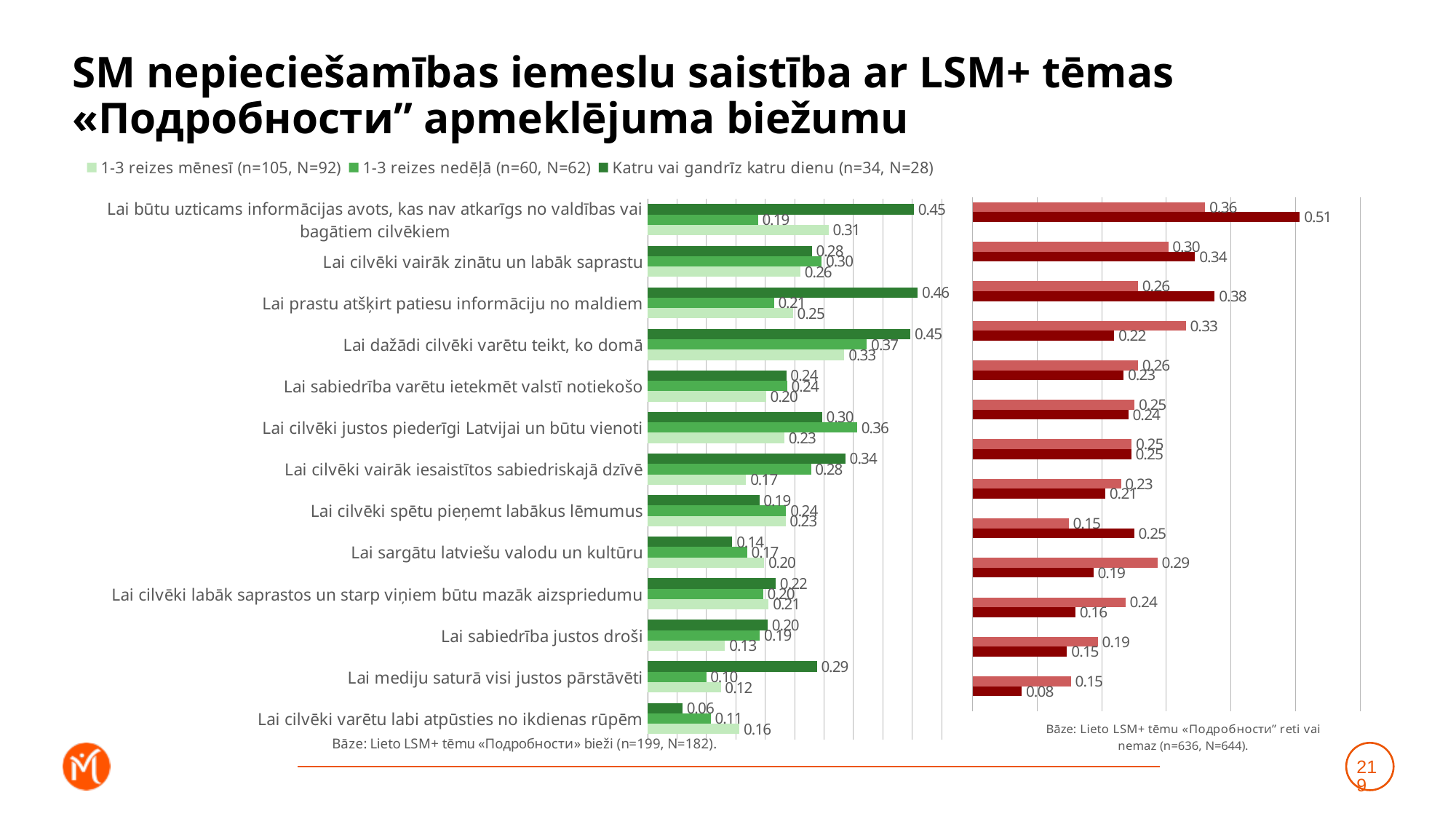
In the left (green) chart, what is the value for '1-3 reizes nedēļā' for 'Lai cilvēki justos piederīgi Latvijai un būtu vienoti'? 0.36 In the left (green) chart, what is the value for 'Katru vai gandrīz katru dienu' for 'Lai prastu atšķirt patiesu informāciju no maldiem'? 0.46 How many categories are shown in the left (green) chart? 13 In the left (green) chart, what is the value for '1-3 reizes mēnesī' for 'Lai sabiedrība justos droši'? 0.13 In the left (green) chart, what is the value for '1-3 reizes mēnesī' for 'Lai būtu uzticams informācijas avots, kas nav atkarīgs no valdības vai bagātiem cilvēkiem'? 0.31 In the right (red) chart, what is the highest value shown? 0.51 In the left (green) chart, what is the difference between the 'Katru vai gandrīz katru dienu' and '1-3 reizes nedēļā' values for 'Lai mediju saturā visi justos pārstāvēti'? 0.19 What kind of chart is the left (green) chart? Bar chart In the left (green) chart, which category has the lowest value for 'Katru vai gandrīz katru dienu'? Lai cilvēki varētu labi atpūsties no ikdienas rūpēm How many series does the legend of the left (green) chart list? 3 In the left (green) chart, which category has the highest value for 'Katru vai gandrīz katru dienu'? Lai prastu atšķirt patiesu informāciju no maldiem In the left (green) chart, for 'Lai sargātu latviešu valodu un kultūru', which is larger: the '1-3 reizes mēnesī' value or the 'Katru vai gandrīz katru dienu' value? 1-3 reizes mēnesī